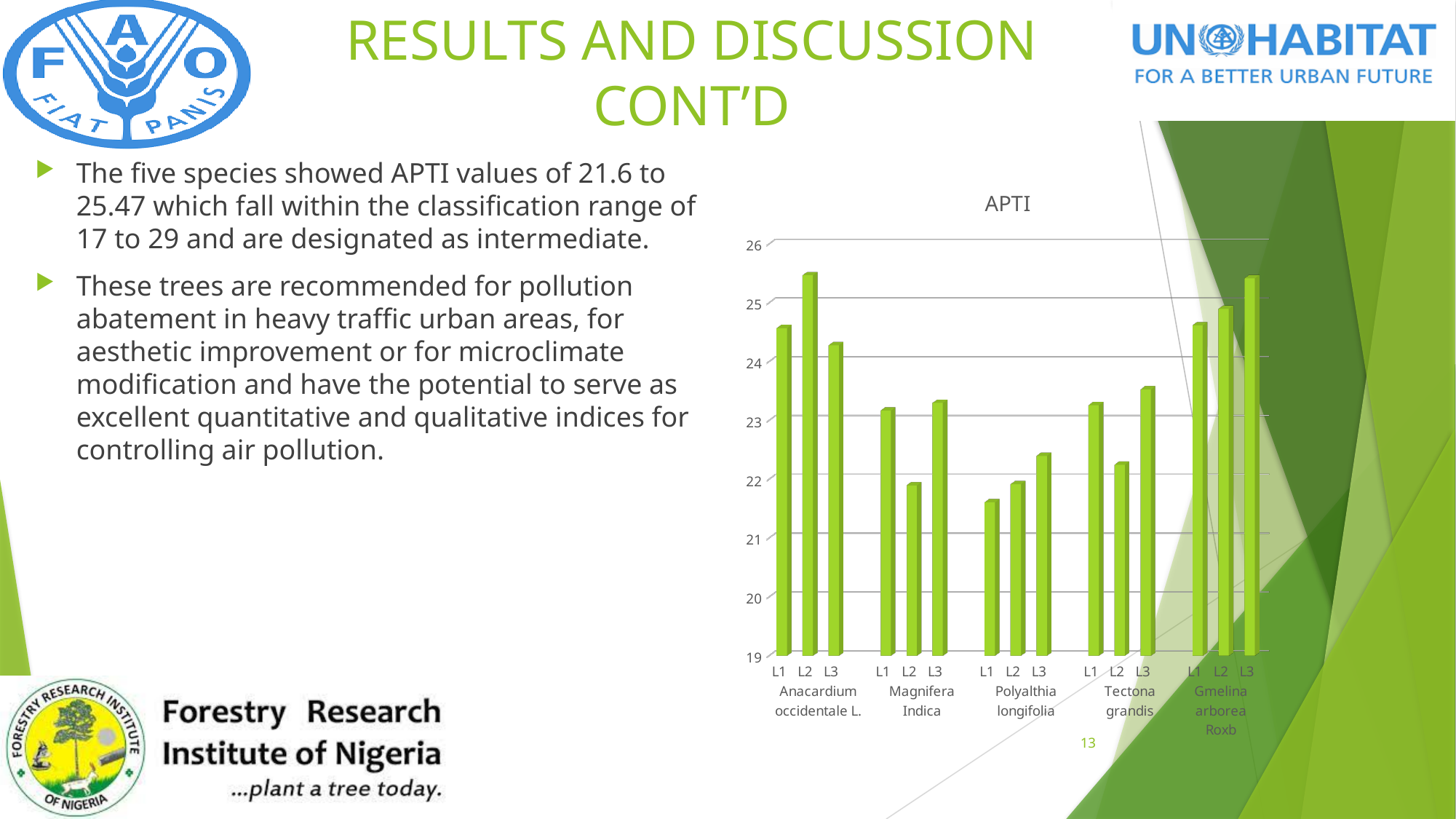
How many bars are plotted in the chart in total? 15 Which has the higher APTI value: L1 of Anacardium occidentale L. or L1 of Polyalthia longifolia? L1 of Anacardium occidentale L. Which has the higher APTI value: L1 of Magnifera Indica or L2 of Magnifera Indica? L1 of Magnifera Indica Is the APTI value for L3 of Gmelina arborea Roxb greater or less than 25? greater Is the APTI value for L2 of Anacardium occidentale L. greater or less than 25? greater Is the APTI value for L3 of Tectona grandis greater or less than 23? greater How many tree species are shown on the x axis of the chart? 5 What type of chart is shown on the slide? bar chart What is the lowest value shown on the y axis of the chart? 19 What is the title of the chart? APTI